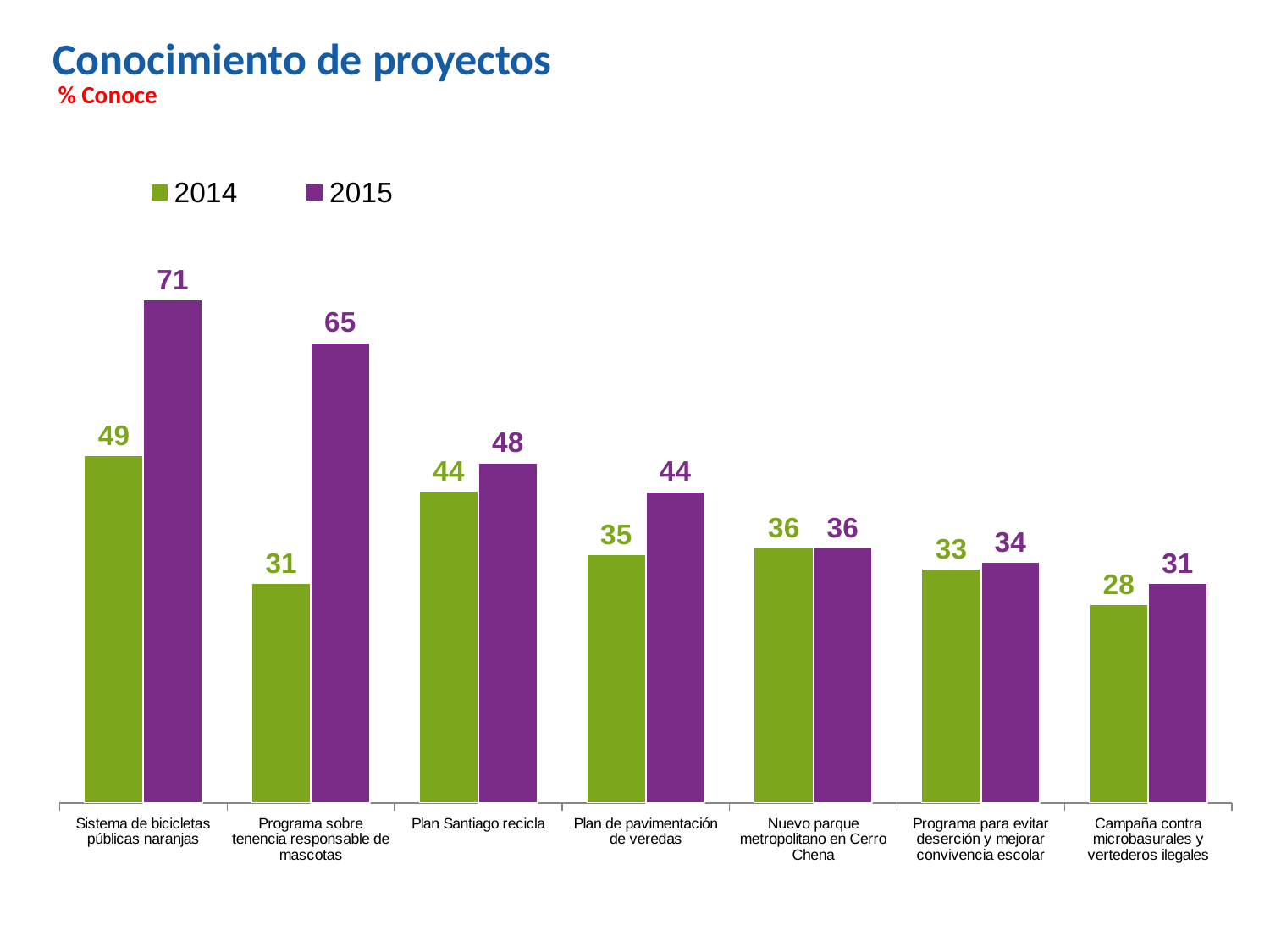
What is the 2014 value for Programa sobre tenencia responsable de mascotas? 31 What is the difference between the 2015 values for Sistema de bicicletas públicas naranjas and Campaña contra microbasurales y vertederos ilegales? 40 What kind of chart is shown on the slide? Bar chart What is the 2015 value for Plan de pavimentación de veredas? 44 How many projects are shown on the chart? 7 What is the difference between the 2015 and 2014 values for Programa sobre tenencia responsable de mascotas? 34 Which project has the lowest 2014 value? Campaña contra microbasurales y vertederos ilegales How many series does the legend list? 2 What is the title of the chart? Conocimiento de proyectos Which project has the highest 2015 value? Sistema de bicicletas públicas naranjas What is the 2015 value for Sistema de bicicletas públicas naranjas? 71 Which is larger for Plan Santiago recicla: the 2014 value or the 2015 value? 2015